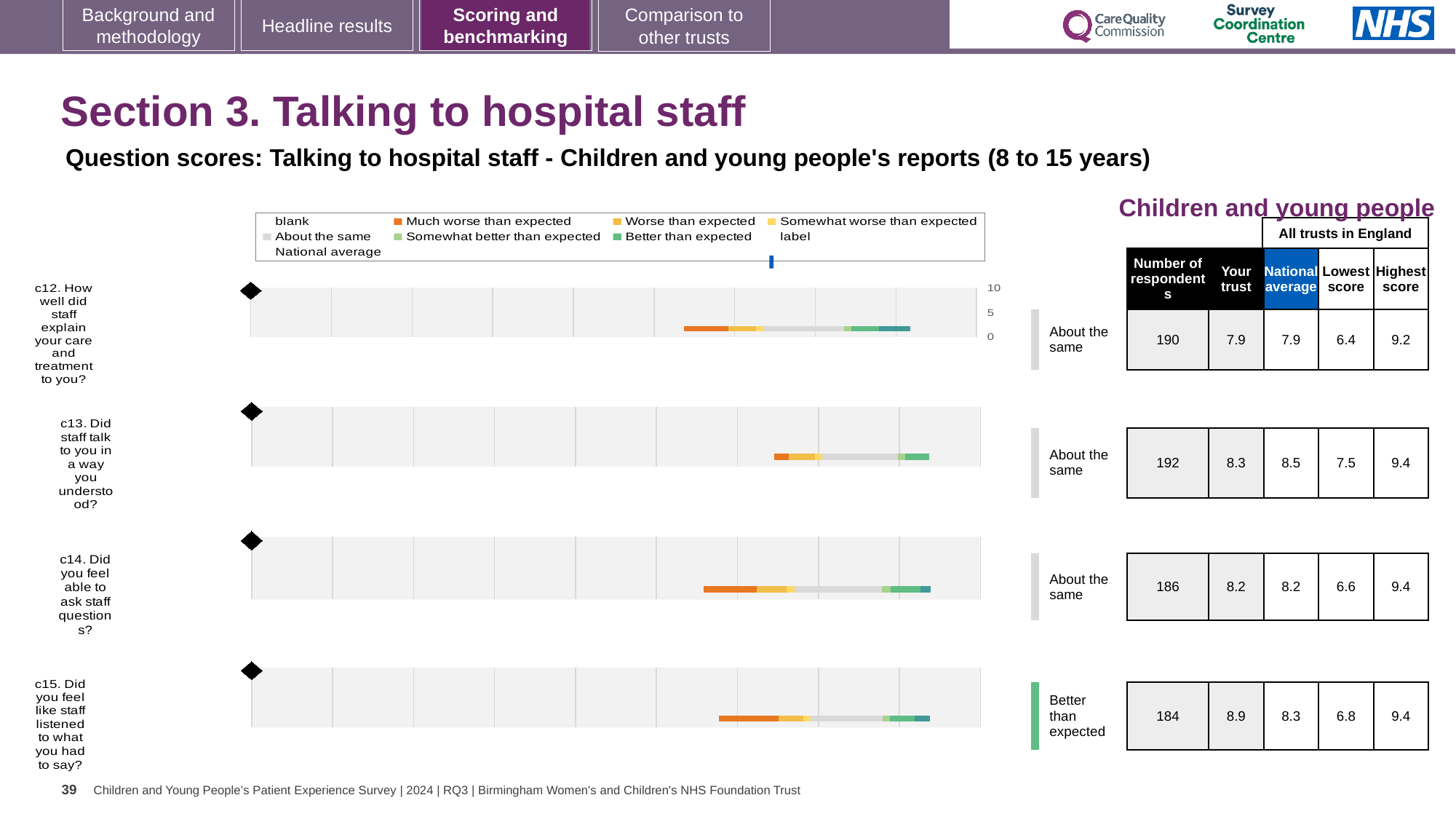
How many of the four questions are labelled 'About the same' beside their charts? 3 In the table next to the charts, what is the 'Your trust' score for c15 (Did you feel like staff listened to what you had to say)? 8.9 Which question has the highest 'Your trust' score in the table next to the charts? c15 For c15, what is the difference between the 'Your trust' score and the 'National average' in the table? 0.6 Which question has the lowest 'Lowest score' value in the table next to the charts? c12 For c13, which is larger in the table: the 'Your trust' score or the 'National average'? National average What colour does the chart legend use for 'Much worse than expected'? orange What kind of chart is used for the c12 to c15 question scores on this slide? bar chart How many survey questions (c12 to c15) have a benchmarking bar chart on this slide? 4 In the table next to the charts, how many respondents are listed for c12 (How well did staff explain your care and treatment to you)? 190 In the table next to the charts, what is the 'Highest score' for c13? 9.4 What benchmark category label is shown beside the c15 chart? Better than expected